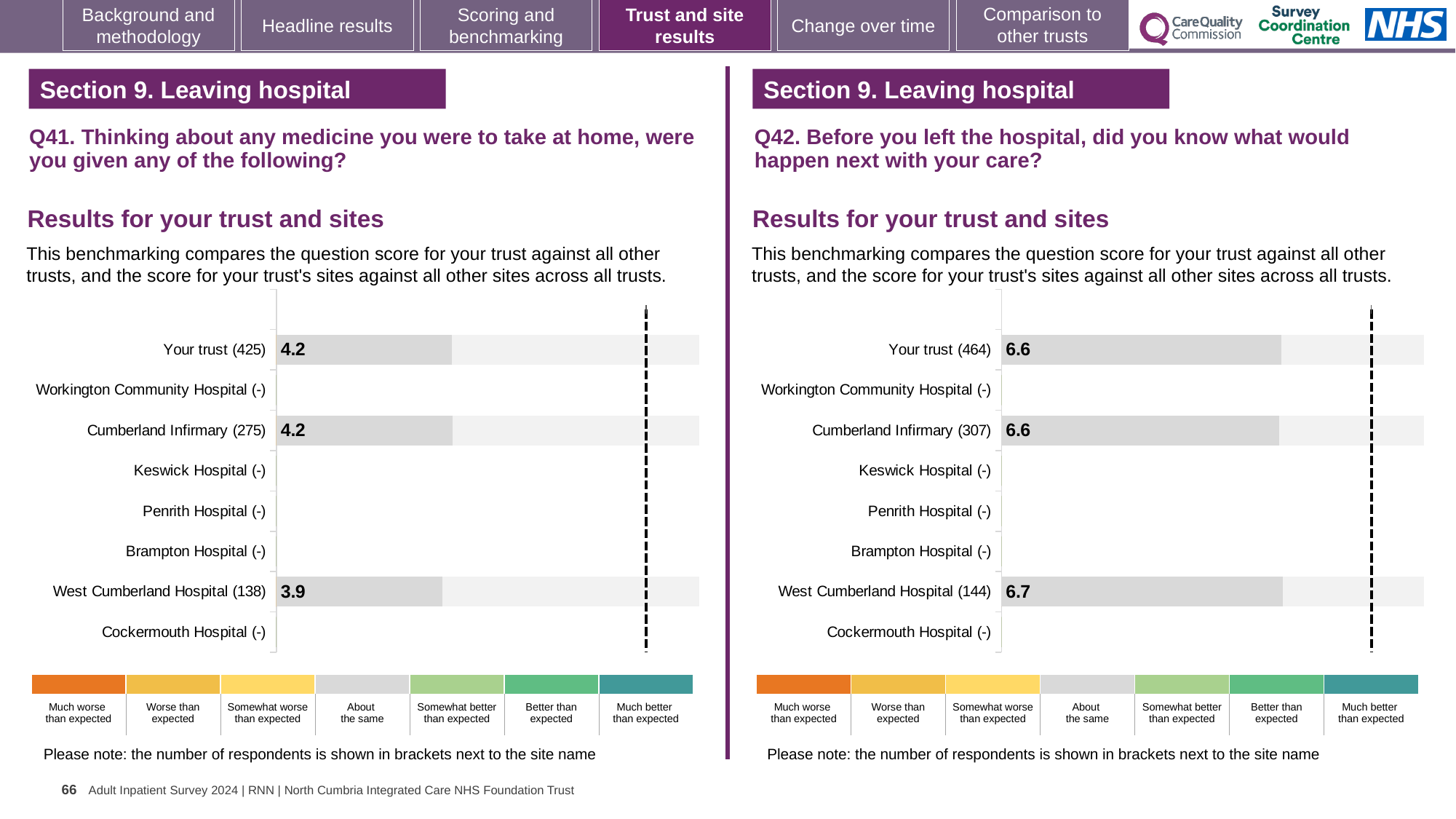
On the Q42 chart (right), what is the difference between the score for West Cumberland Hospital and the score for Cumberland Infirmary? 0.1 On the Q42 chart (right), what is the score for West Cumberland Hospital? 6.7 On the Q41 chart (left), what is the score for Your trust? 4.2 On the Q41 chart (left), what is the difference between the score for Your trust and the score for West Cumberland Hospital? 0.3 On the Q42 chart (right), which is larger: the score for West Cumberland Hospital or the score for Your trust? West Cumberland Hospital On the Q42 chart (right), what is the score for Your trust? 6.6 On the Q41 chart (left), which site with a plotted score has the lowest score? West Cumberland Hospital How many site/trust categories are listed on the Q41 chart (left)? 8 On the Q41 chart (left), what is the score for West Cumberland Hospital? 3.9 What kind of chart is used on the Q42 chart (right)? Bar chart On the Q42 chart (right), which site with a plotted score has the highest score? West Cumberland Hospital On the Q41 chart (left), what is the score for Cumberland Infirmary? 4.2